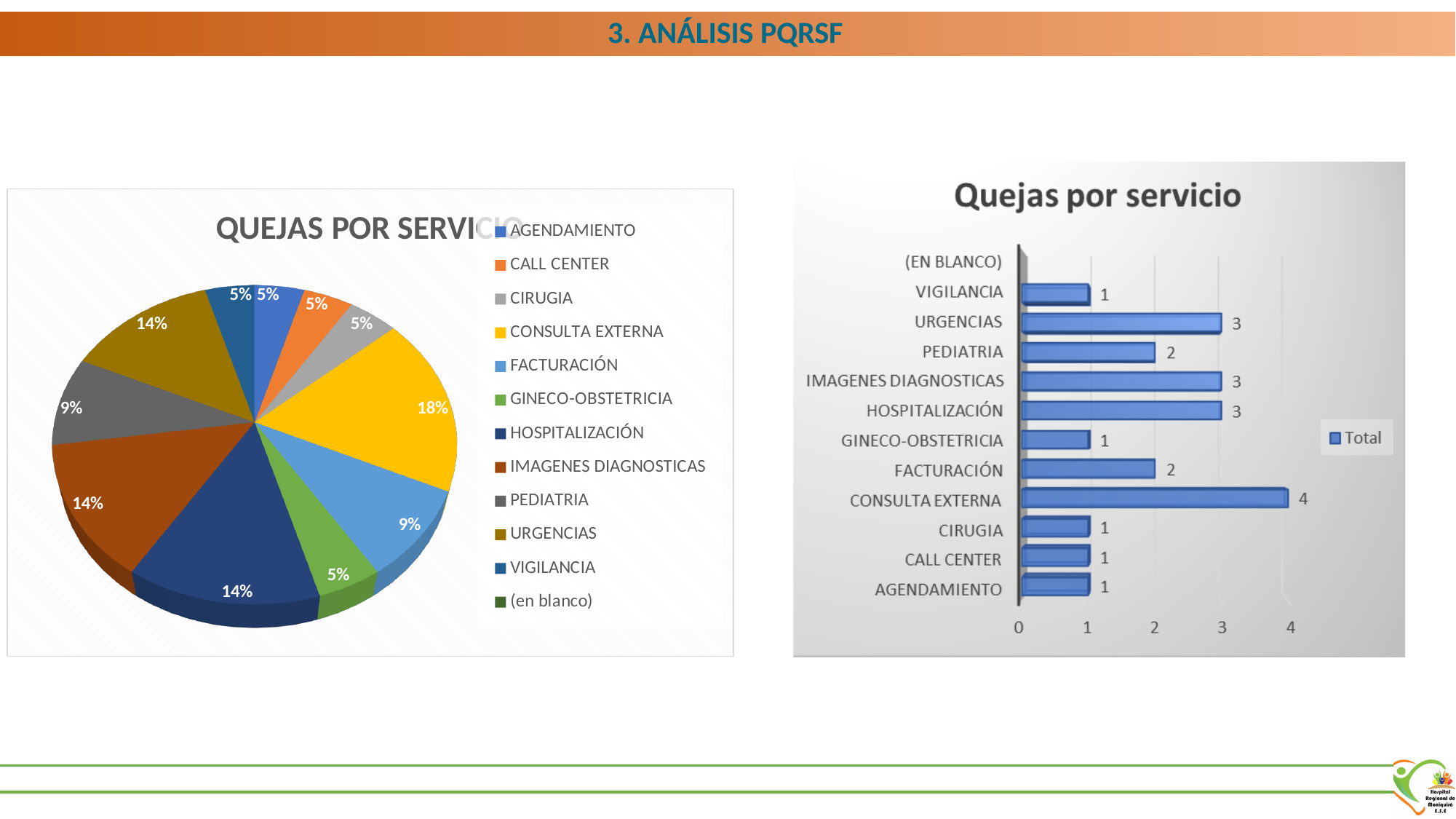
In the pie chart on the left, what share does FACTURACIÓN have? 9% In the bar chart on the right, which category has the highest value? CONSULTA EXTERNA In the pie chart on the left, what share does CONSULTA EXTERNA have? 18% In the bar chart on the right, what is the difference between the values for URGENCIAS and VIGILANCIA? 2 In the bar chart on the right, what is the value for CONSULTA EXTERNA? 4 What kind of chart is the chart on the right? Bar chart In the bar chart on the right, what is the value for PEDIATRIA? 2 In the bar chart on the right, how many series does the legend list? 1 What kind of chart is the chart on the left? Pie chart What is the title of the chart on the right? Quejas por servicio In the bar chart on the right, which is larger, the value for HOSPITALIZACIÓN or the value for FACTURACIÓN? HOSPITALIZACIÓN In the pie chart on the left, which category has the largest slice? CONSULTA EXTERNA